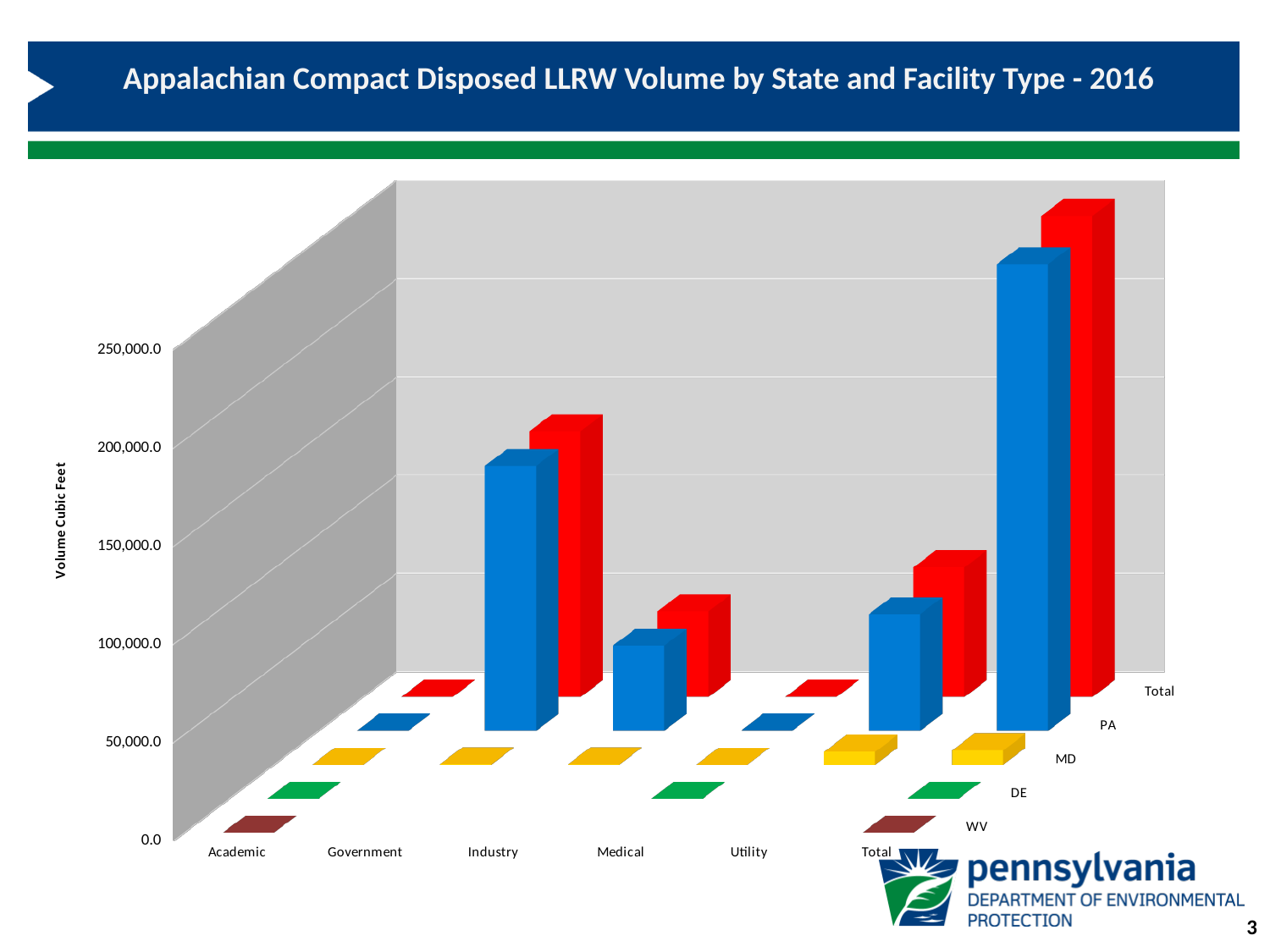
Is the PA value for Total greater or less than 200,000.0? greater How many series (states plus Total) are labelled along the depth axis of the chart? 5 How many facility type categories are shown along the x axis? 6 For PA, which is larger: the Industry volume or the Medical volume? Industry Which facility type category has the highest PA volume? Total Among the individual facility types (excluding Total), which has the highest PA volume? Government Is the PA value for Medical greater or less than 150,000.0? less What is the label on the vertical axis of the chart? Volume Cubic Feet Is the PA value for Industry greater or less than 100,000.0? less What kind of chart is shown on the slide? bar chart What is the title of the chart? Appalachian Compact Disposed LLRW Volume by State and Facility Type - 2016